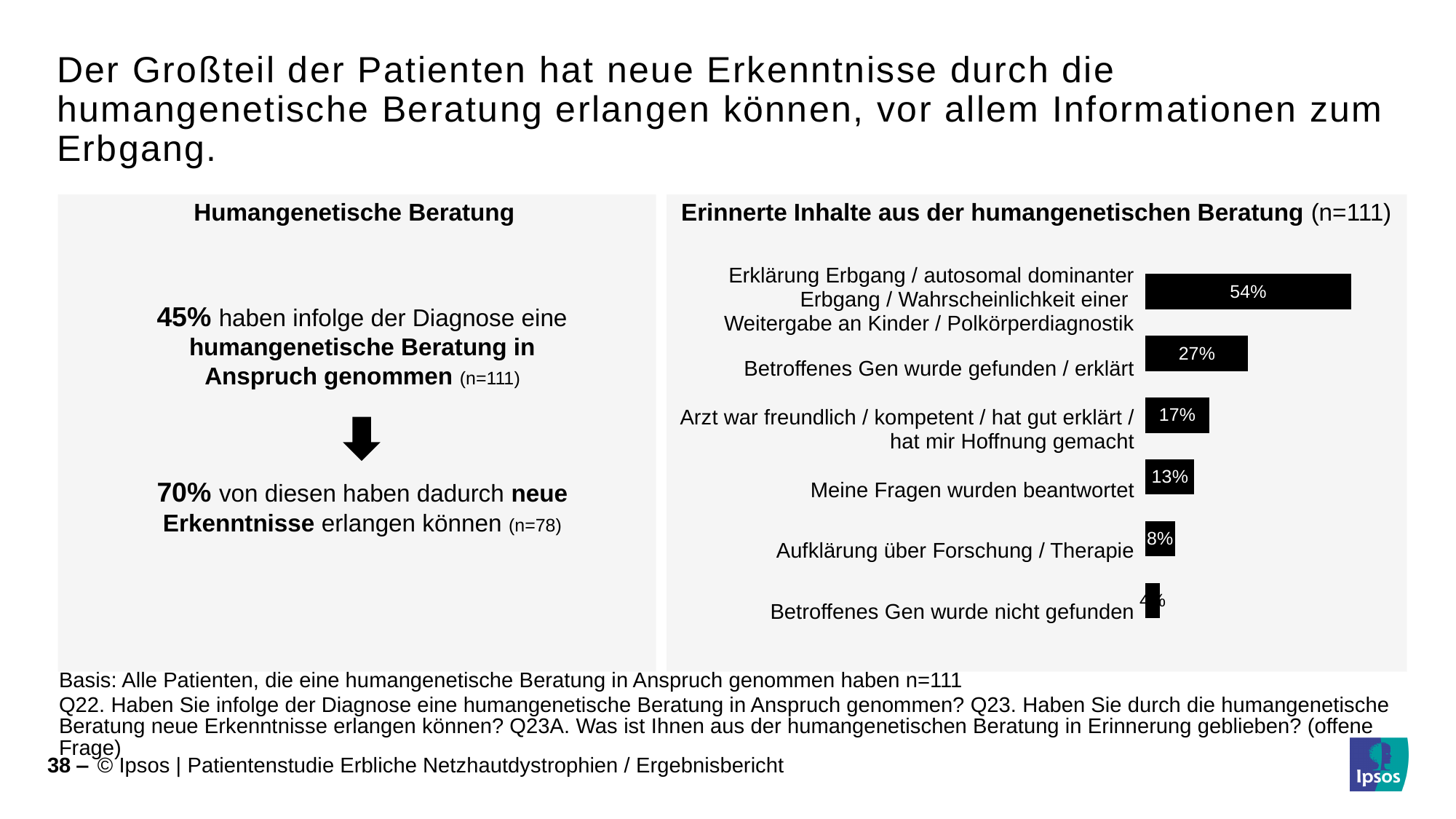
In the chart "Erinnerte Inhalte aus der humangenetischen Beratung", what is the difference between the values for "Erklärung Erbgang / autosomal dominanter Erbgang / Wahrscheinlichkeit einer Weitergabe an Kinder / Polkörperdiagnostik" and "Betroffenes Gen wurde gefunden / erklärt"? 27% In the chart "Erinnerte Inhalte aus der humangenetischen Beratung", what is the value for "Arzt war freundlich / kompetent / hat gut erklärt / hat mir Hoffnung gemacht"? 17% In the chart "Erinnerte Inhalte aus der humangenetischen Beratung", what is the value for "Aufklärung über Forschung / Therapie"? 8% What sample size (n) is given in the title of the chart "Erinnerte Inhalte aus der humangenetischen Beratung"? n=111 In the chart "Erinnerte Inhalte aus der humangenetischen Beratung", what is the difference between the values for "Arzt war freundlich / kompetent / hat gut erklärt / hat mir Hoffnung gemacht" and "Aufklärung über Forschung / Therapie"? 9% In the chart "Erinnerte Inhalte aus der humangenetischen Beratung", which is larger: the value for "Meine Fragen wurden beantwortet" or for "Aufklärung über Forschung / Therapie"? Meine Fragen wurden beantwortet What kind of chart is shown under "Erinnerte Inhalte aus der humangenetischen Beratung"? Bar chart In the chart "Erinnerte Inhalte aus der humangenetischen Beratung", which category has the lowest value? Betroffenes Gen wurde nicht gefunden In the chart "Erinnerte Inhalte aus der humangenetischen Beratung", what is the value for "Betroffenes Gen wurde gefunden / erklärt"? 27% In the chart "Erinnerte Inhalte aus der humangenetischen Beratung", what is the value for "Meine Fragen wurden beantwortet"? 13% In the chart "Erinnerte Inhalte aus der humangenetischen Beratung", which category has the highest value? Erklärung Erbgang / autosomal dominanter Erbgang / Wahrscheinlichkeit einer Weitergabe an Kinder / Polkörperdiagnostik How many categories are shown in the chart "Erinnerte Inhalte aus der humangenetischen Beratung"? 6